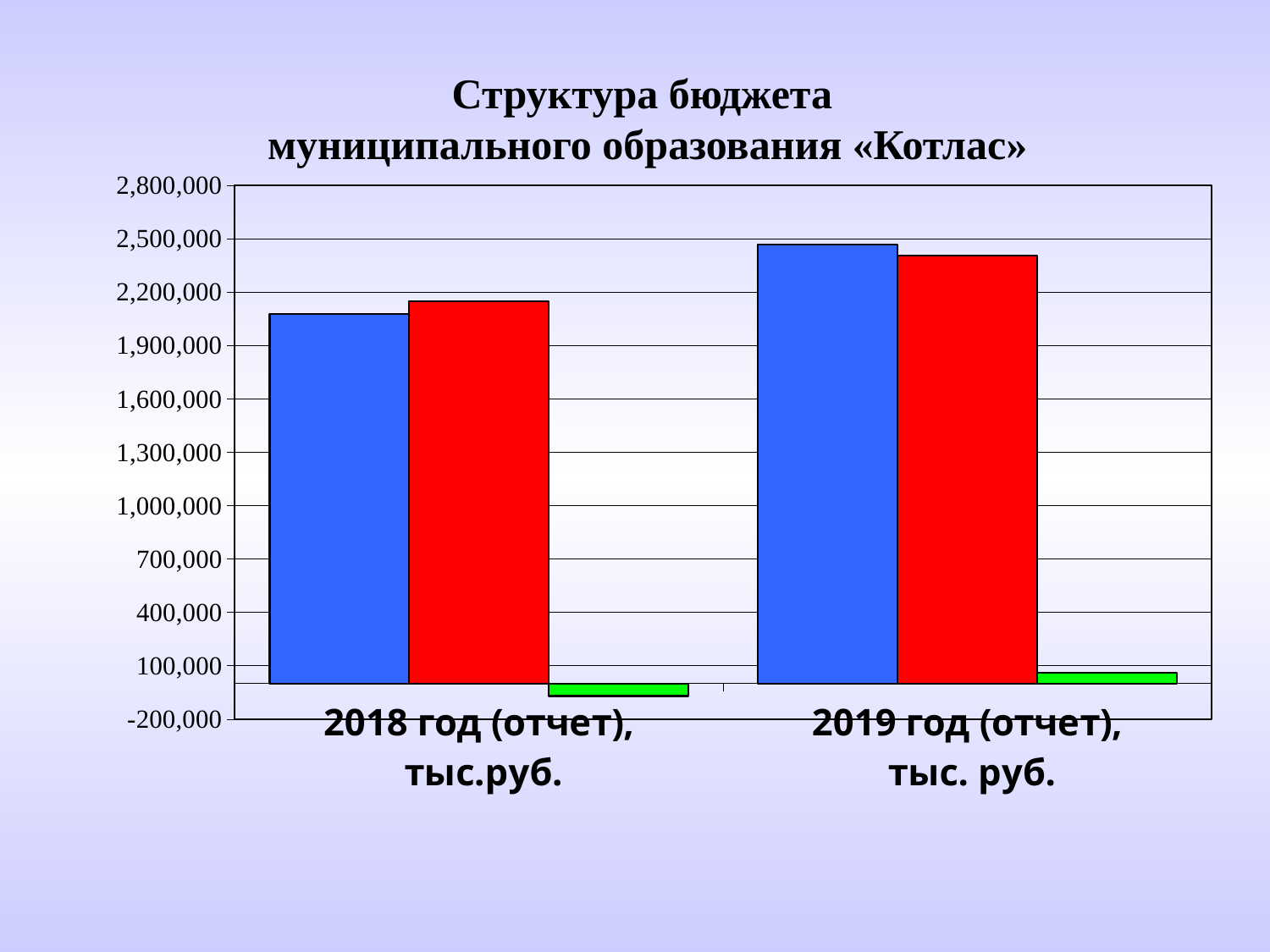
Is the green bar for 2018 год (отчет) above or below zero? below Is the value of the green bar for 2019 год (отчет) greater or less than 400,000? less What is the title of the chart? Структура бюджета муниципального образования «Котлас» What kind of chart is shown on the slide? bar chart For 2018 год (отчет), which bar is taller, the blue one or the red one? the red one Is the value of the blue bar for 2019 год (отчет) greater or less than 2,200,000? greater For 2019 год (отчет), which bar is taller, the blue one or the red one? the blue one Does the blue bar rise or fall from 2018 год (отчет) to 2019 год (отчет)? rise How many categories are shown on the x axis? 2 How many bars are plotted for each year category? 3